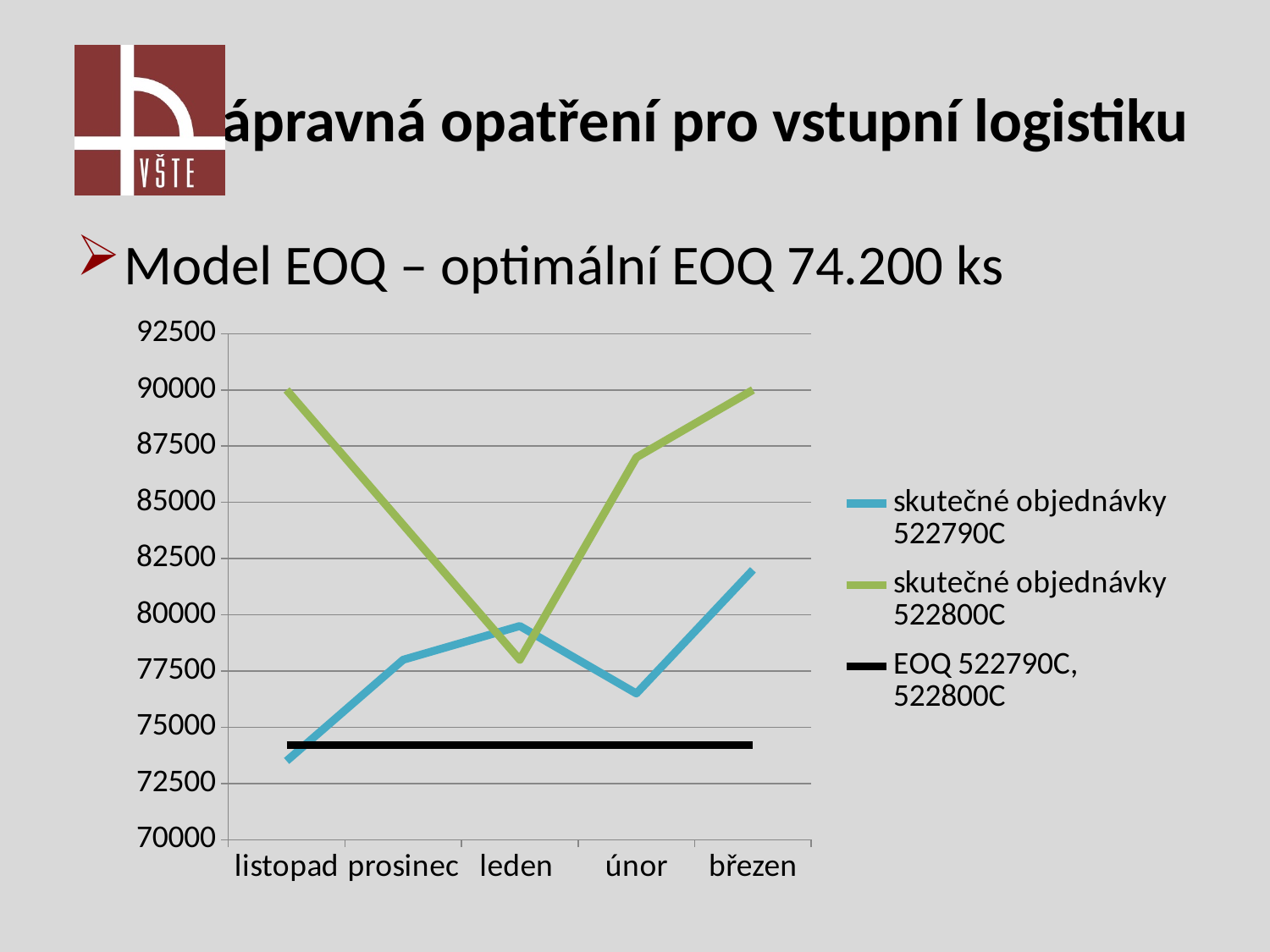
What kind of chart is shown on the slide? line chart Is the value for skutečné objednávky 522800C in prosinec greater or less than 82500? greater How many months are shown on the x axis? 5 What is the value of skutečné objednávky 522800C in listopad? 90000 Is the value for skutečné objednávky 522790C in listopad greater or less than 75000? less What colour is the EOQ 522790C, 522800C line? black In which month is skutečné objednávky 522800C at its lowest? leden Is the value for skutečné objednávky 522790C in březen greater or less than 80000? greater In which month is skutečné objednávky 522790C at its highest? březen How many series does the legend list? 3 In únor, which series is higher: skutečné objednávky 522790C or skutečné objednávky 522800C? skutečné objednávky 522800C Does the skutečné objednávky 522800C line rise or fall from listopad to leden? fall